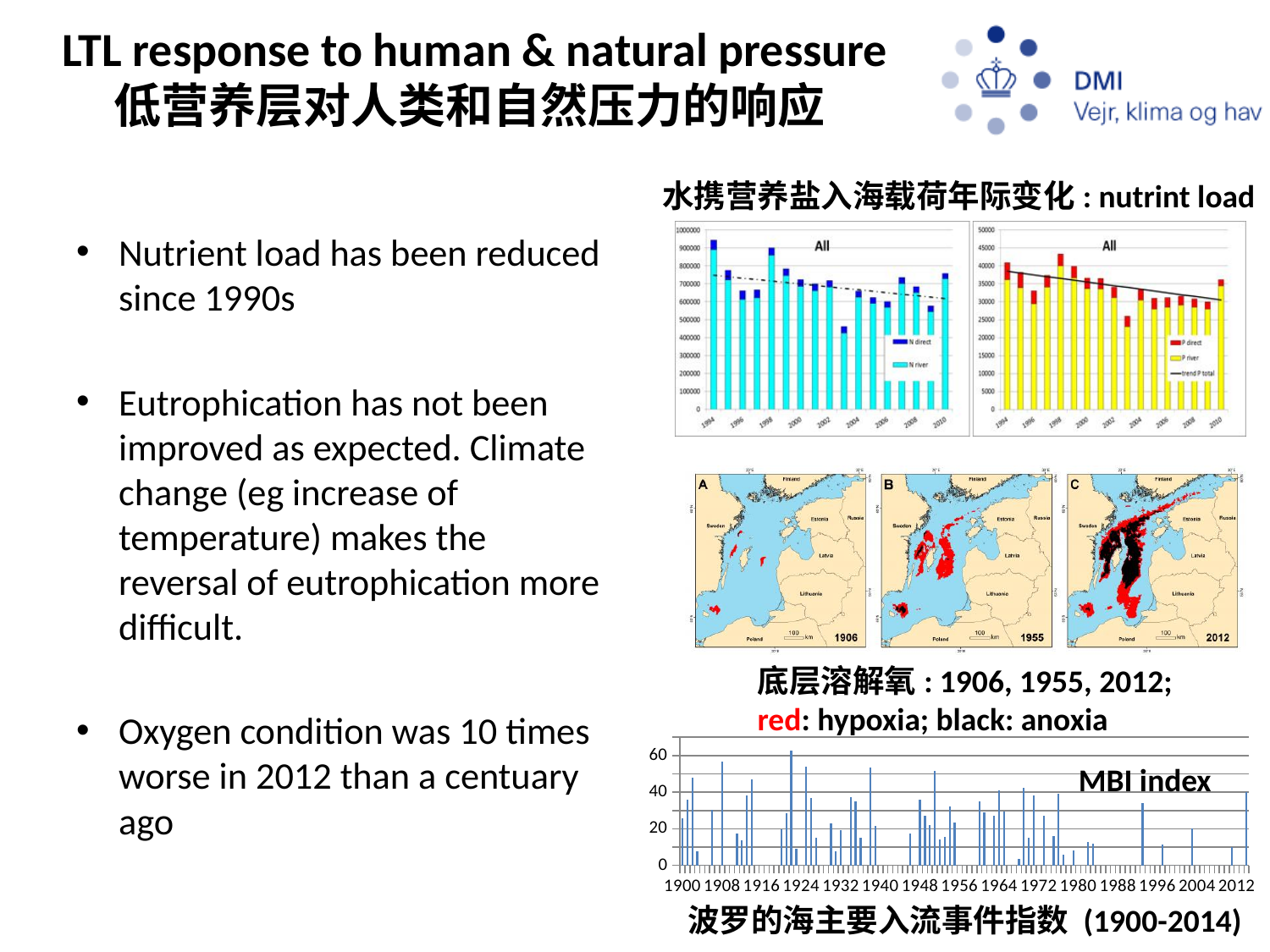
In the MBI index chart, what is the last year label shown on the x axis? 2012 In the right nutrient load chart (P), is the total bar for 2004 greater or less than 30000? less How many year labels are shown on the x axis of the MBI index chart? 15 In the left nutrient load chart (N), is the total bar for 1994 greater or less than 800000? greater In the left nutrient load chart, what colour are the N river bars? cyan In the right nutrient load chart (P), how many entries does the legend list? 3 In the MBI index chart, is the tallest bar (around 1922) greater or less than 40? greater What title appears above both nutrient load bar charts? All In the left nutrient load chart (N), how many series does the legend list? 2 What kind of chart is the MBI index chart at the bottom right of the slide? bar chart In the right nutrient load chart (P), does the trend P total line rise or fall from 1994 to 2010? fall